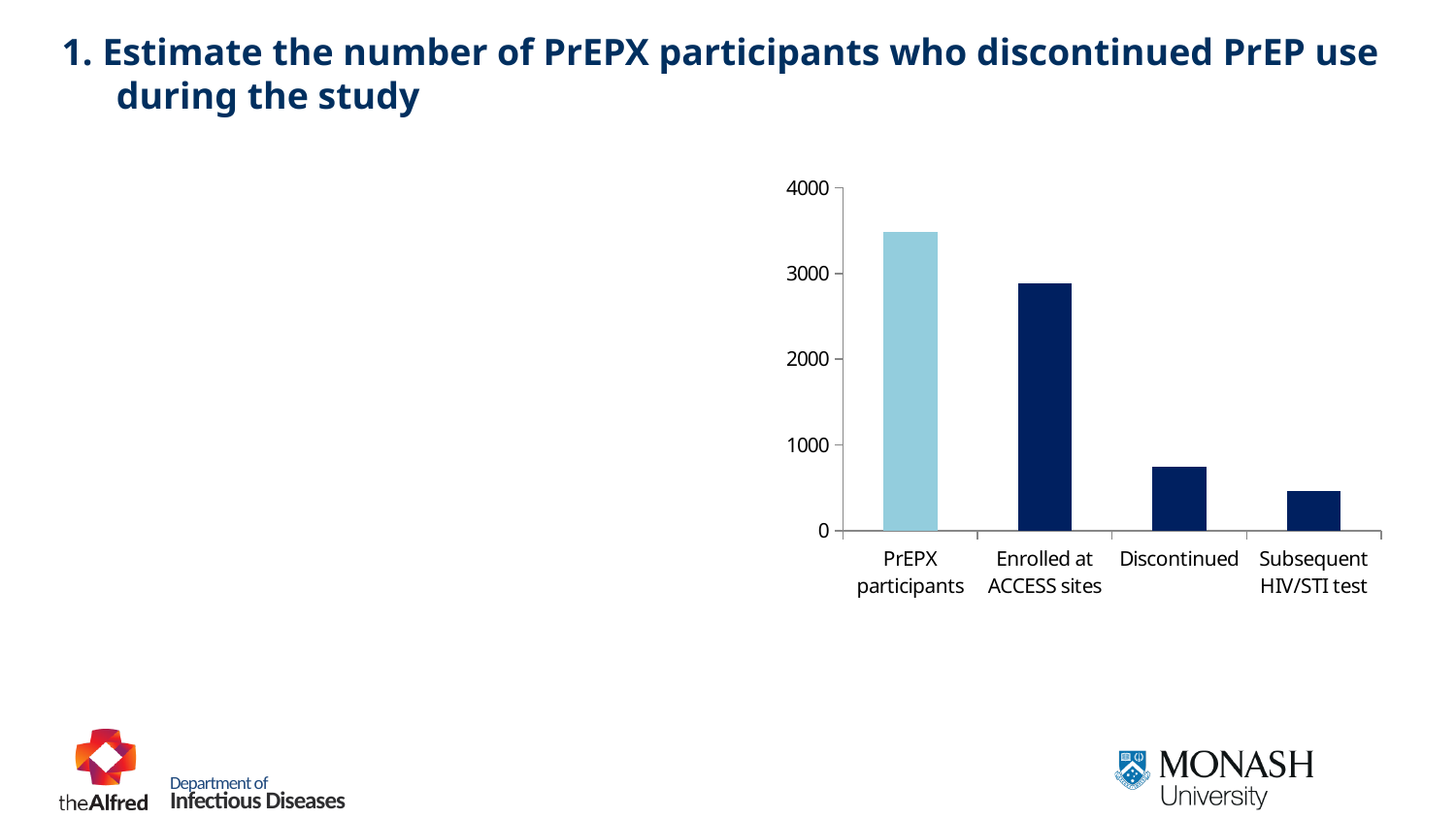
Is the value for Subsequent HIV/STI test greater or less than 1000? less Is the value for Enrolled at ACCESS sites greater or less than 2000? greater Is the value for Discontinued greater or less than 1000? less What kind of chart is shown on the slide? bar chart Which is larger, the value for Enrolled at ACCESS sites or the value for Discontinued? Enrolled at ACCESS sites Which is larger, the value for Discontinued or the value for Subsequent HIV/STI test? Discontinued How many categories are plotted on the chart? 4 Which category has the highest value? PrEPX participants Which bar is coloured light blue rather than dark navy? PrEPX participants Which category has the lowest value? Subsequent HIV/STI test Do the values rise or fall from left to right across the categories? fall